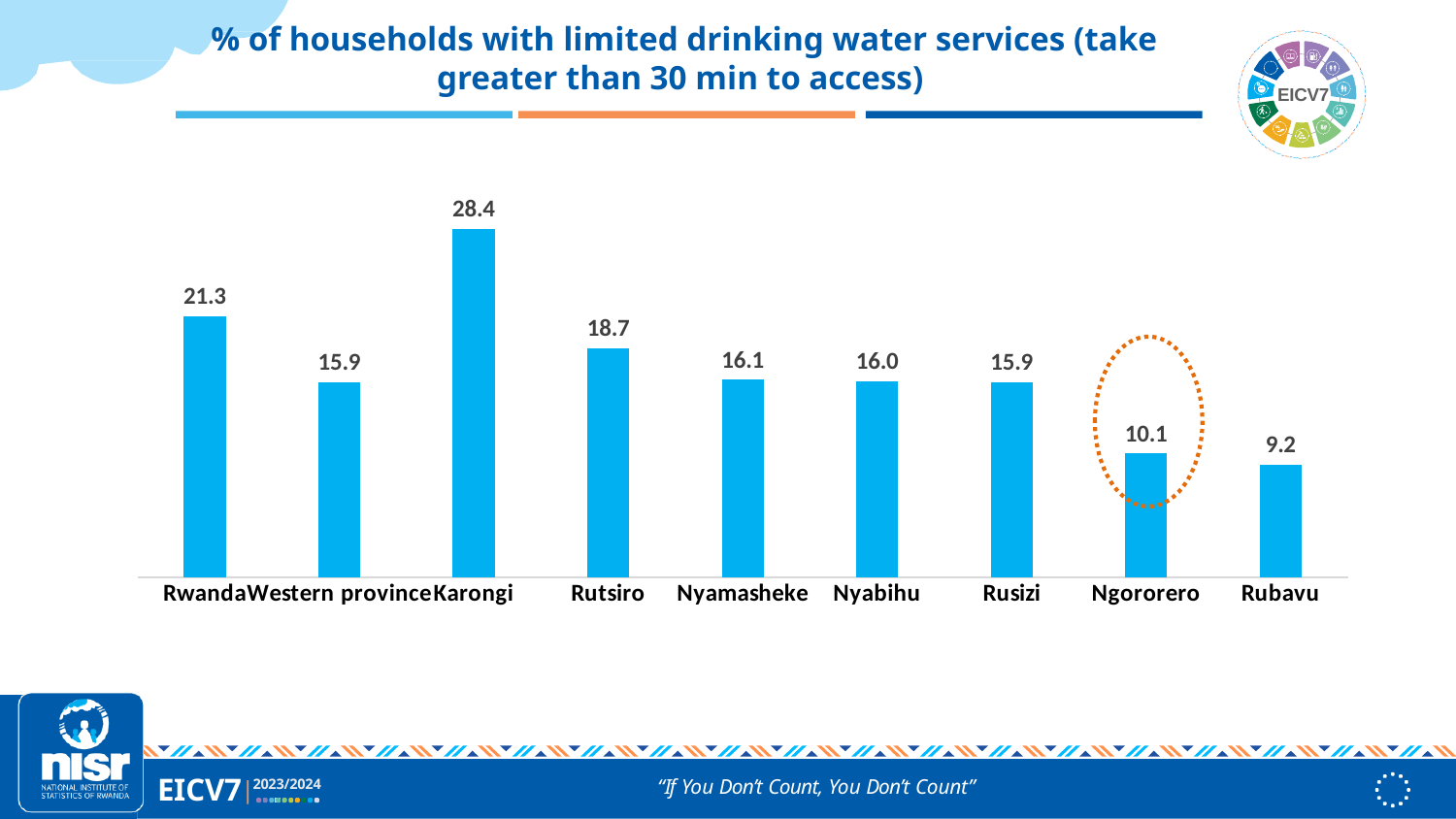
Which is larger, the value for Rutsiro or the value for Nyamasheke? Rutsiro What is the value for Ngororero? 10.1 What is the difference between the values for Rwanda and Western province? 5.4 What is the difference between the values for Karongi and Rubavu? 19.2 What is the value for Karongi? 28.4 What kind of chart is shown on the slide? Bar chart What is the value for Rutsiro? 18.7 Which category has the lowest value? Rubavu What is the value for Rwanda? 21.3 Which category has the highest value? Karongi How many categories are shown on the x axis? 9 Which category's bar is circled with a dotted orange outline? Ngororero